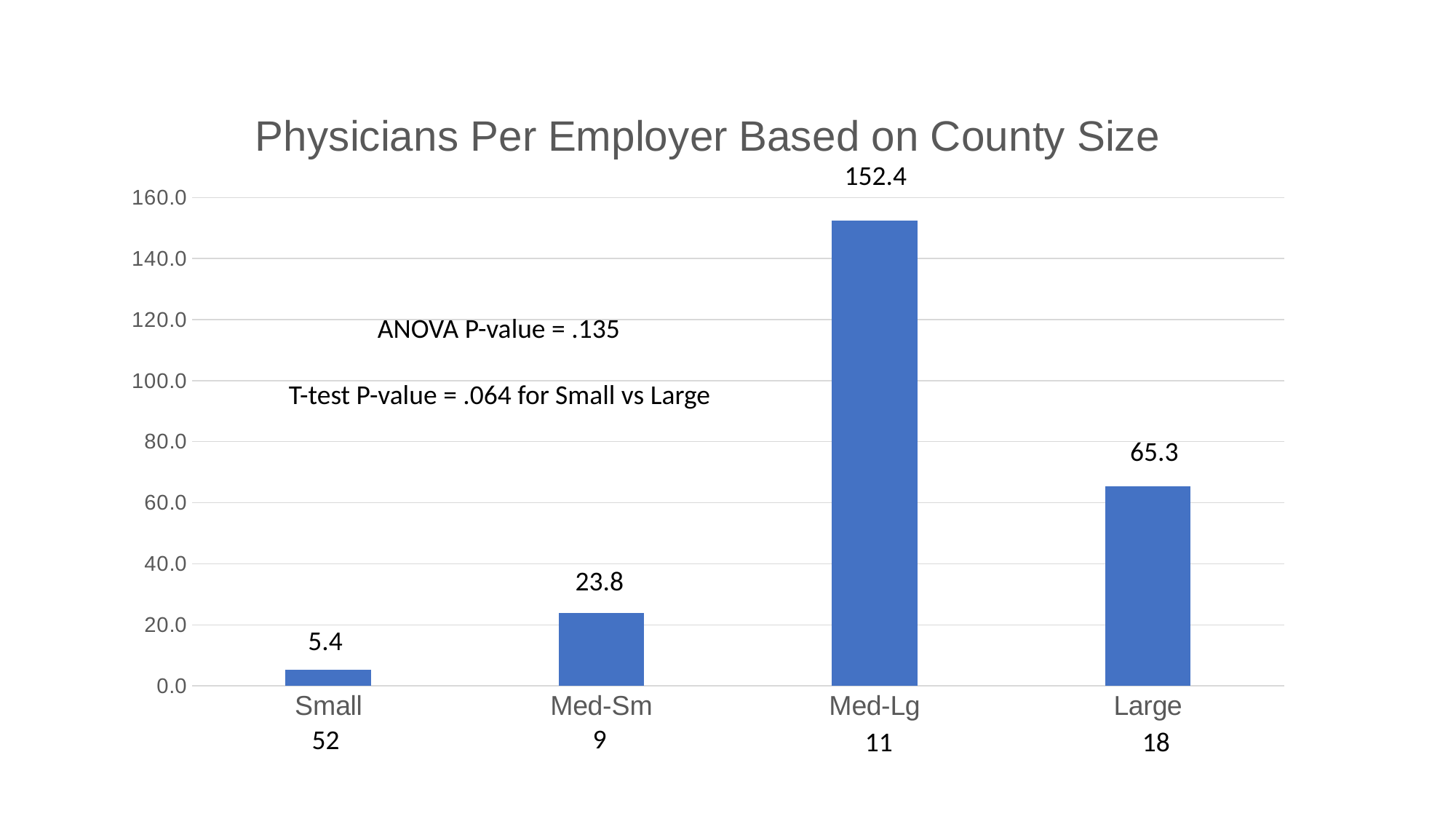
Is the value for Med-Lg greater or less than 140? greater What is the difference between the values for Med-Sm and Small? 18.4 Which is larger, the value for Large or the value for Med-Sm? Large What is the value for Med-Lg? 152.4 Which county size has the highest value? Med-Lg What is the value for Large? 65.3 What is the difference between the values for Med-Lg and Large? 87.1 What is the title of the chart? Physicians Per Employer Based on County Size What is the value for Small? 5.4 Which county size has the lowest value? Small What kind of chart is shown on the slide? bar chart How many county size categories are shown on the chart? 4